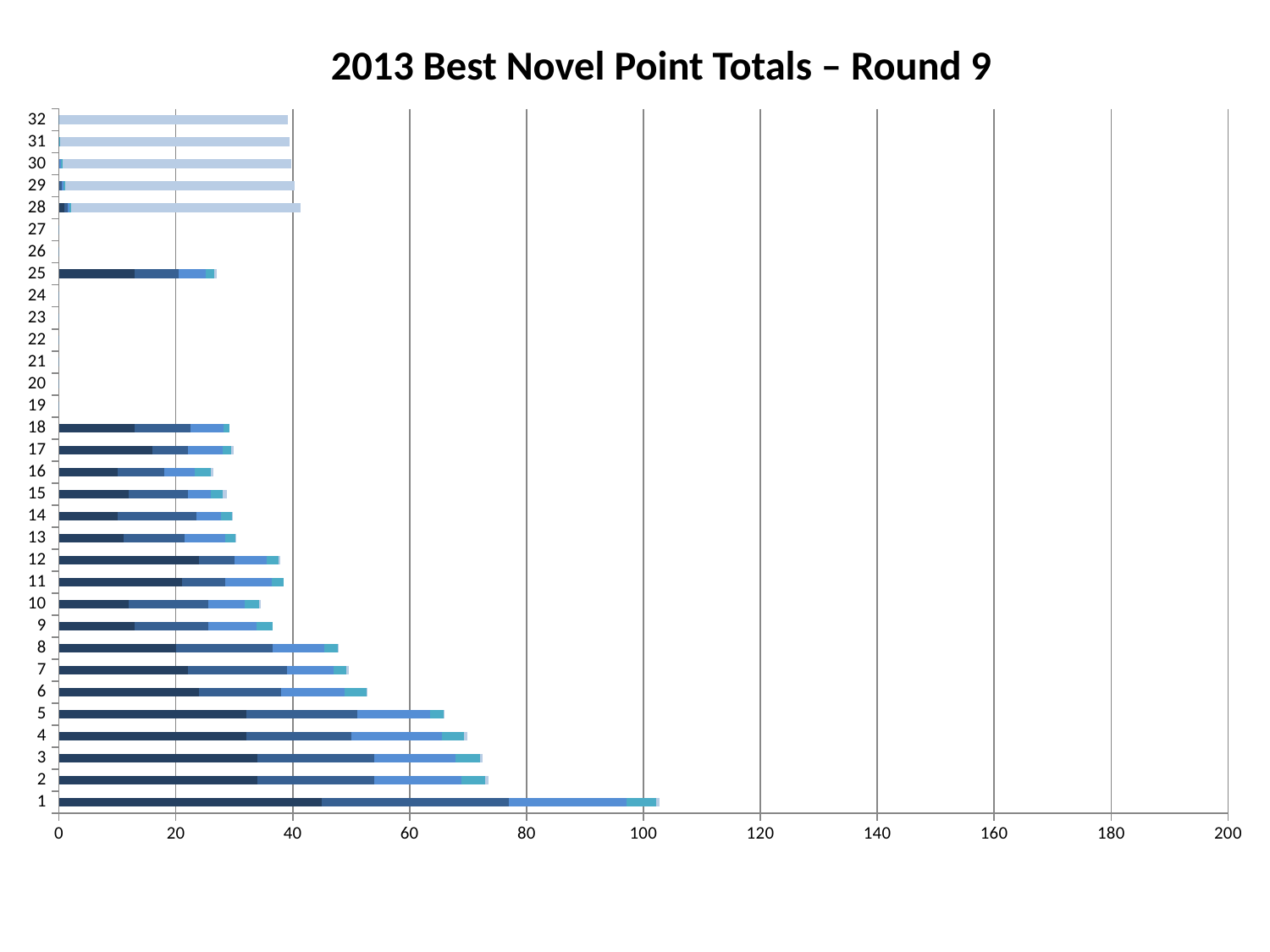
Which has the larger total, category 1 or category 2? 1 Is the total for category 8 greater or less than 40? greater Is the total for category 1 greater or less than 80? greater Which has the larger total, category 5 or category 6? 5 Is the total for category 25 greater or less than 40? less What is the highest value shown on the horizontal axis? 200 Which category has the highest total in the chart? 1 How many categories are listed on the vertical axis of the chart? 32 What is the title of the chart? 2013 Best Novel Point Totals – Round 9 What kind of chart is shown on the slide? bar chart